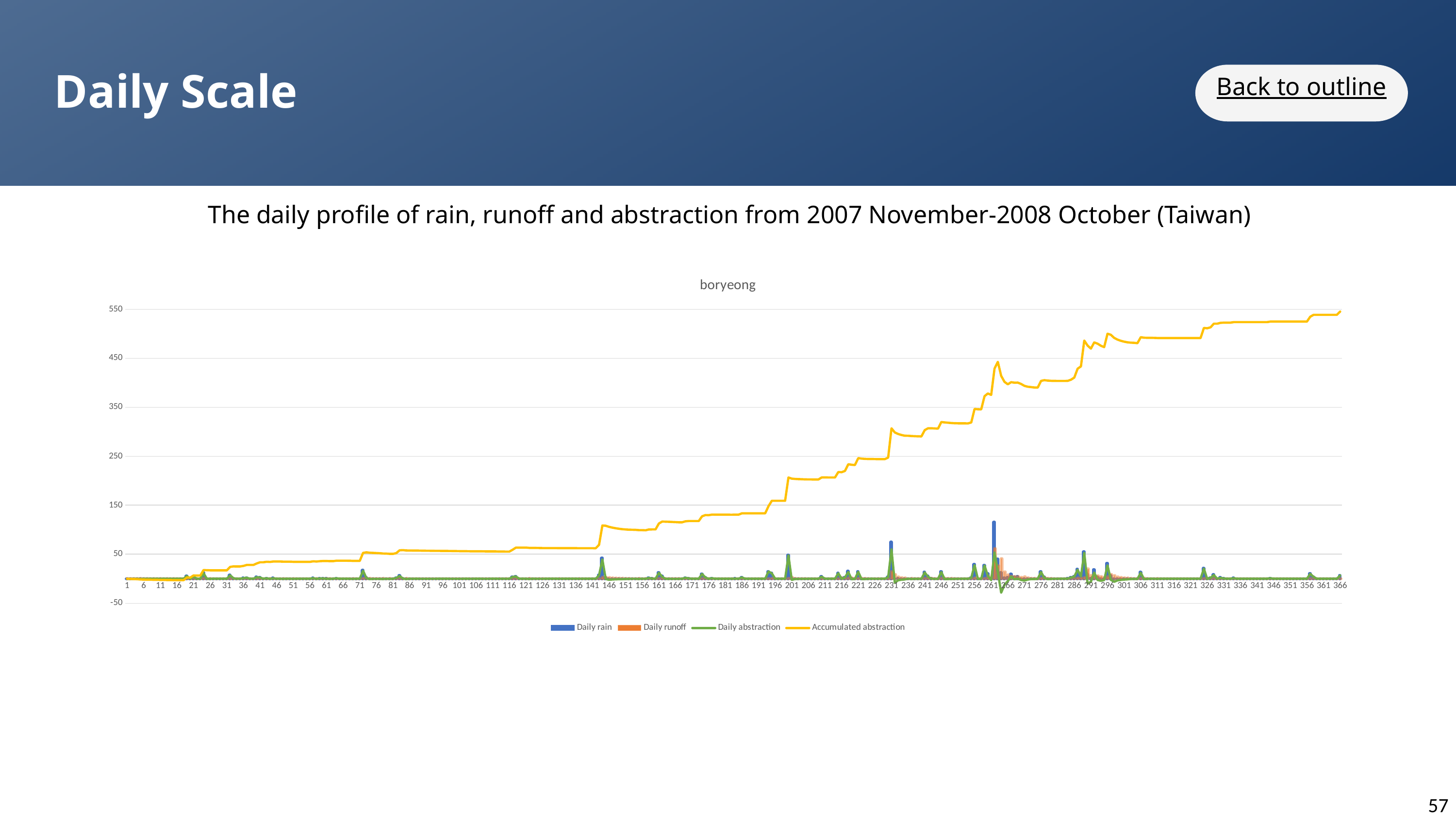
How many series does the chart legend list? 4 Is the value of Accumulated abstraction at day 231 greater or less than 350? less Is the tallest Daily rain bar greater or less than 50? greater What is the title of the chart? boryeong Does the Accumulated abstraction series rise or fall overall from day 1 to day 366? rise Is the value of Accumulated abstraction at day 201 greater or less than 150? greater Which is larger: Accumulated abstraction at day 291 or at day 201? day 291 Is the Accumulated abstraction series drawn as a line or as bars? line Which series reaches the highest value on the chart? Accumulated abstraction Which series is drawn in yellow? Accumulated abstraction